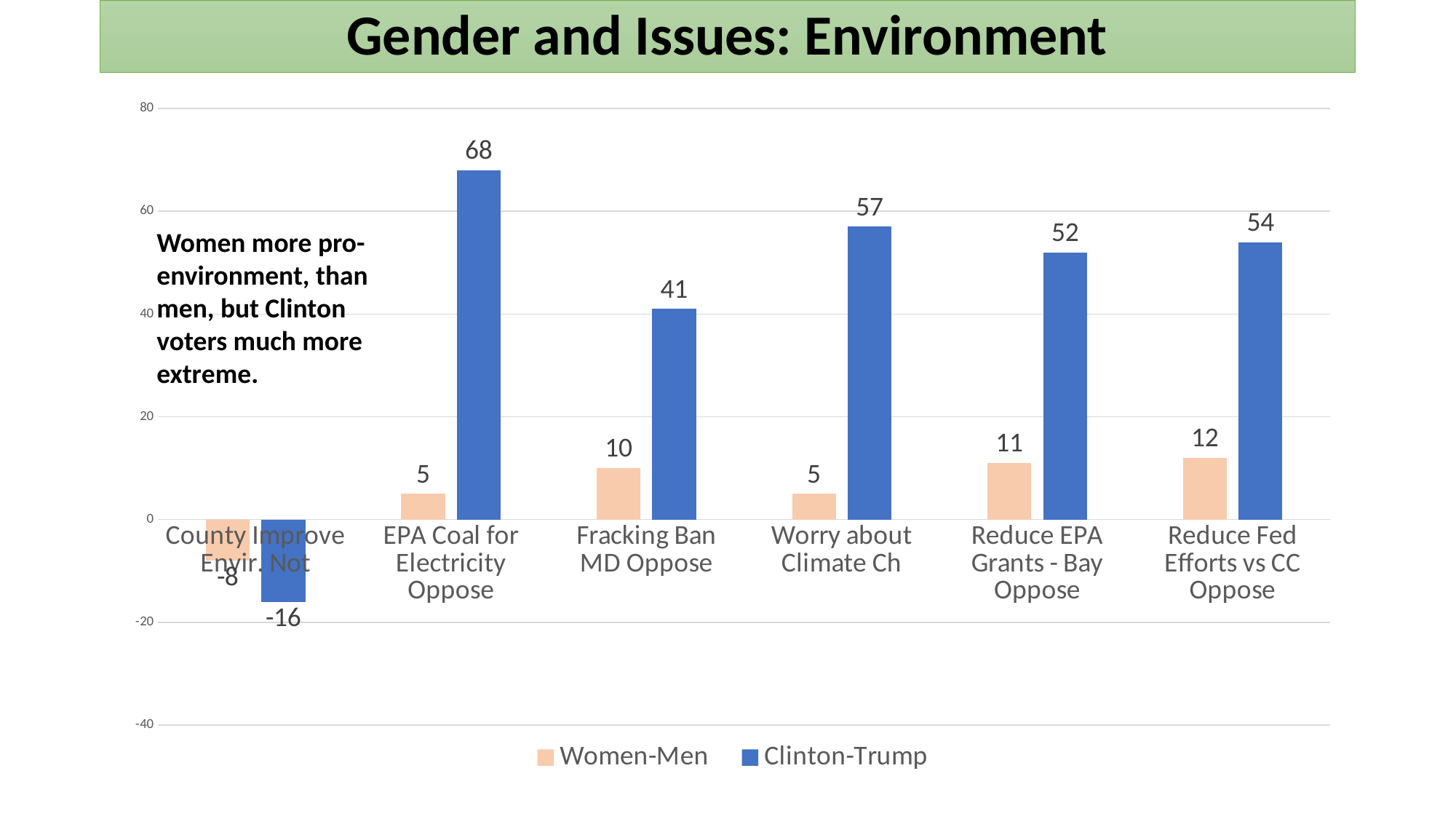
Which is larger, the Clinton-Trump value for Fracking Ban MD Oppose or for Reduce EPA Grants - Bay Oppose? Reduce EPA Grants - Bay Oppose How many categories are shown on the x axis? 6 What is the Women-Men value for Reduce Fed Efforts vs CC Oppose? 12 How many series does the legend list? 2 Which category has the highest Clinton-Trump value? EPA Coal for Electricity Oppose What is the Clinton-Trump value for County Improve Envir. Not? -16 What are the two series named in the legend? Women-Men and Clinton-Trump What kind of chart is shown on the slide? Bar chart What is the difference between the Clinton-Trump and Women-Men values for Worry about Climate Ch? 52 What is the Women-Men value for Fracking Ban MD Oppose? 10 What is the Clinton-Trump value for EPA Coal for Electricity Oppose? 68 Which category has the lowest Women-Men value? County Improve Envir. Not